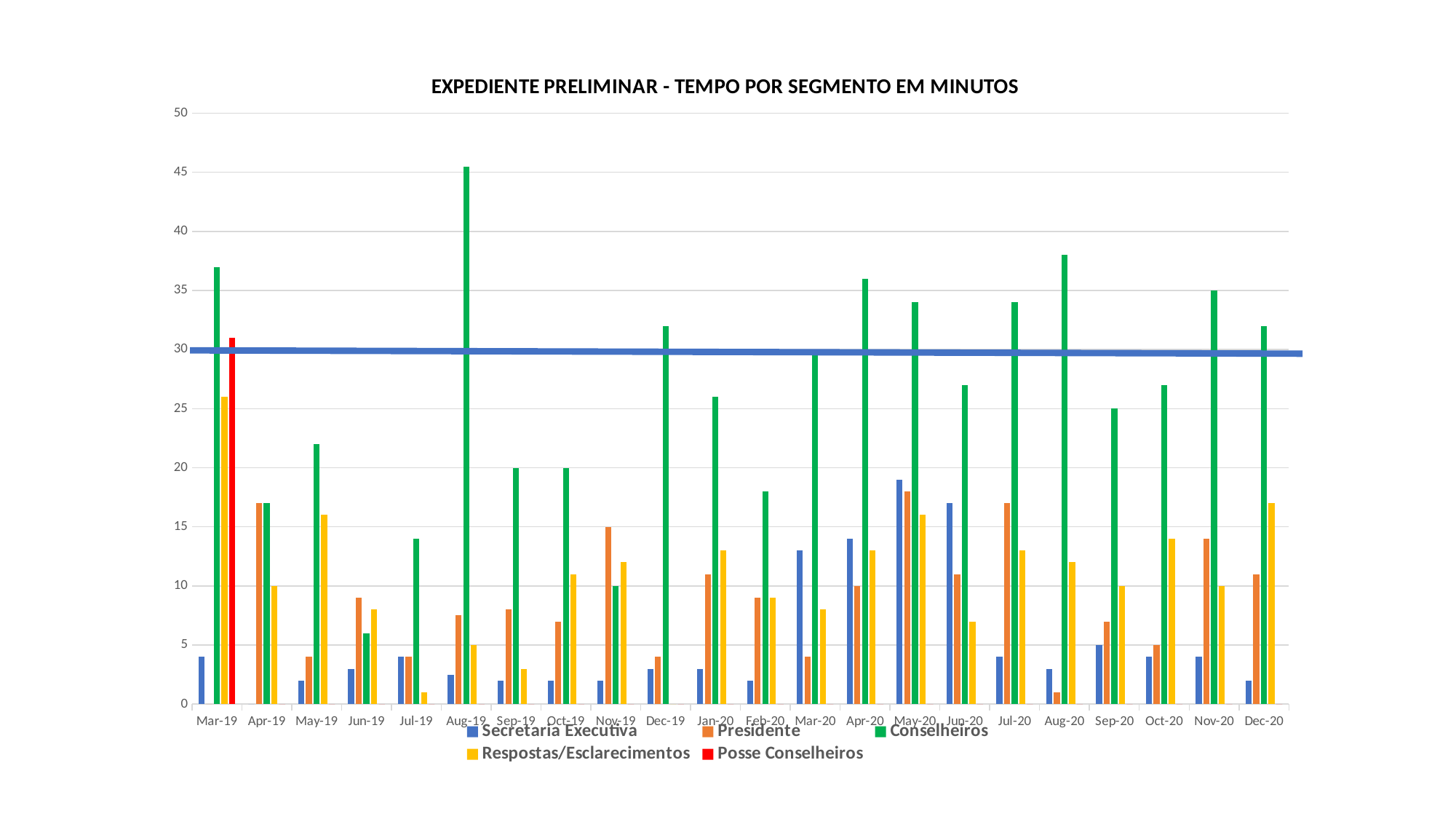
Which is larger, the Presidente value for Apr-19 or for Jun-19? Apr-19 In how many months does the Posse Conselheiros series have a bar? 1 In which month is the Conselheiros value lowest? Jun-19 What kind of chart is shown on the slide? bar chart In which month is the Conselheiros value highest? Aug-19 Is the Respostas/Esclarecimentos value for Mar-19 greater or less than 20? greater How many months are shown along the x axis? 22 Is the Conselheiros value for Jun-19 greater or less than 10? less How many series does the legend list? 5 Which is larger, the Conselheiros value for Aug-19 or for Mar-19? Aug-19 What is the title of the chart? EXPEDIENTE PRELIMINAR - TEMPO POR SEGMENTO EM MINUTOS Is the Conselheiros value for Aug-19 greater or less than 40? greater